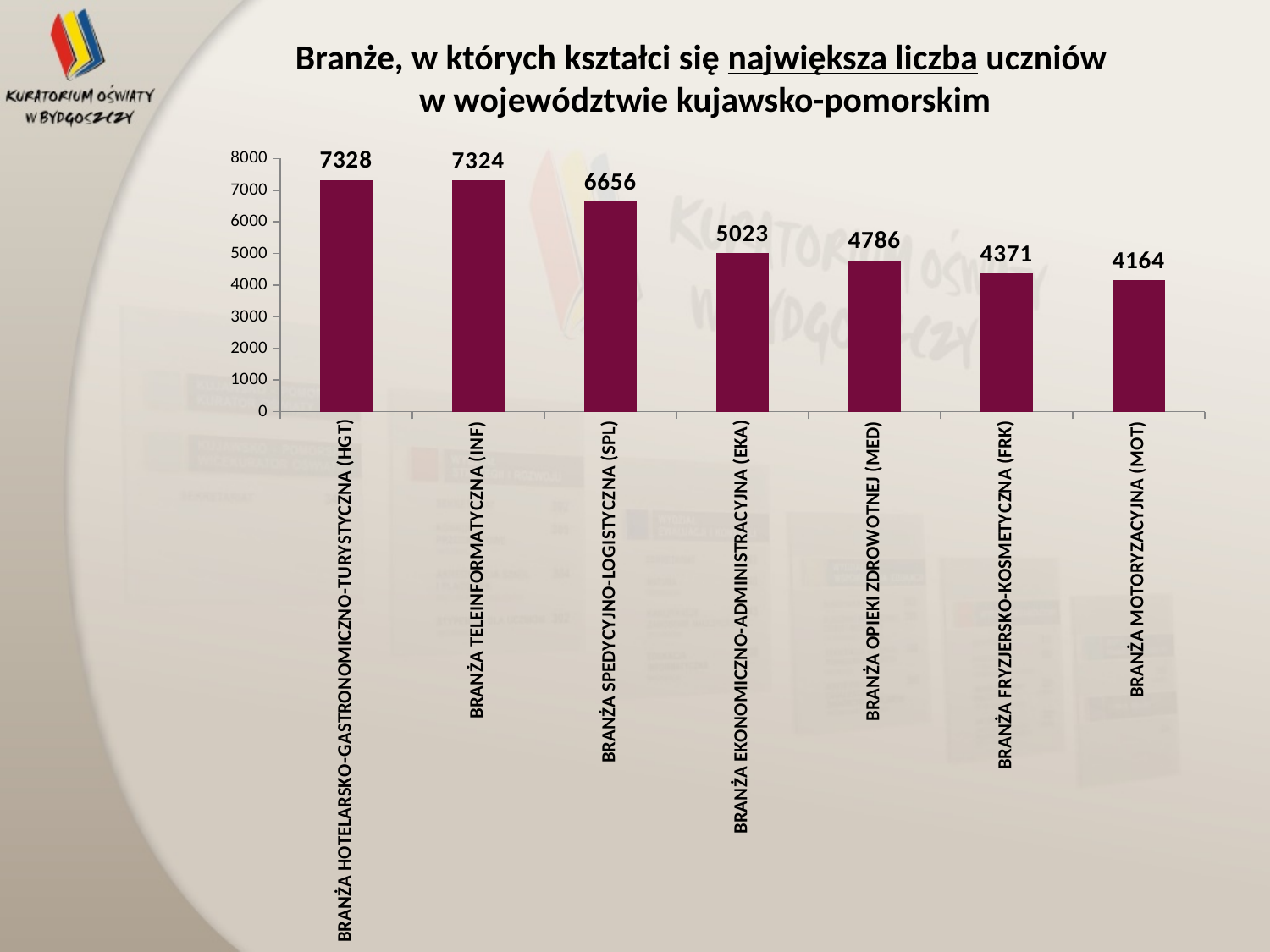
What is the difference between the values for BRANŻA EKONOMICZNO-ADMINISTRACYJNA (EKA) and BRANŻA FRYZJERSKO-KOSMETYCZNA (FRK)? 652 Do the values rise or fall from left to right along the x axis? fall Is the value for BRANŻA HOTELARSKO-GASTRONOMICZNO-TURYSTYCZNA (HGT) greater or less than 7000? greater Which industry has the lowest number of students? BRANŻA MOTORYZACYJNA (MOT) What is the difference between the values for BRANŻA HOTELARSKO-GASTRONOMICZNO-TURYSTYCZNA (HGT) and BRANŻA TELEINFORMATYCZNA (INF)? 4 What is the value for BRANŻA TELEINFORMATYCZNA (INF)? 7324 How many industries (categories) are shown in the chart? 7 What is the value for BRANŻA SPEDYCYJNO-LOGISTYCZNA (SPL)? 6656 What type of chart is shown on the slide? bar chart Which is larger, the value for BRANŻA SPEDYCYJNO-LOGISTYCZNA (SPL) or BRANŻA EKONOMICZNO-ADMINISTRACYJNA (EKA)? BRANŻA SPEDYCYJNO-LOGISTYCZNA (SPL) What is the value for BRANŻA OPIEKI ZDROWOTNEJ (MED)? 4786 What is the value for BRANŻA MOTORYZACYJNA (MOT)? 4164